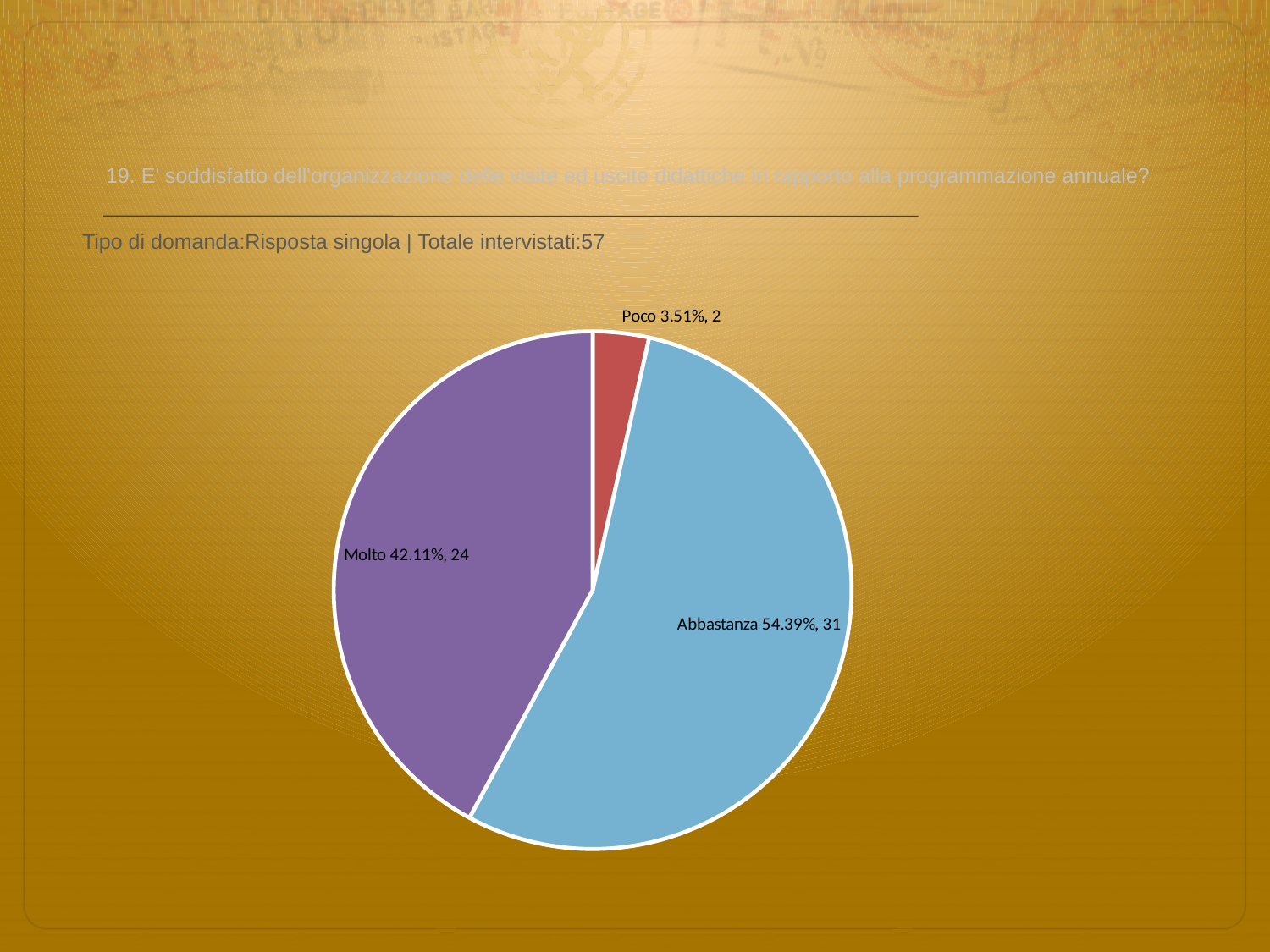
Which category has the largest slice? Abbastanza What is the difference in respondent count between Abbastanza and Molto? 7 What percentage share does the Abbastanza slice have? 54.39% Which category has the smallest slice? Poco How many slices does the pie chart have? 3 How many respondents answered Molto? 24 How many respondents answered Poco? 2 How many respondents answered Abbastanza? 31 What kind of chart is shown on the slide? pie chart What percentage share does the Molto slice have? 42.11% Which has more respondents, Molto or Poco? Molto What percentage share does the Poco slice have? 3.51%